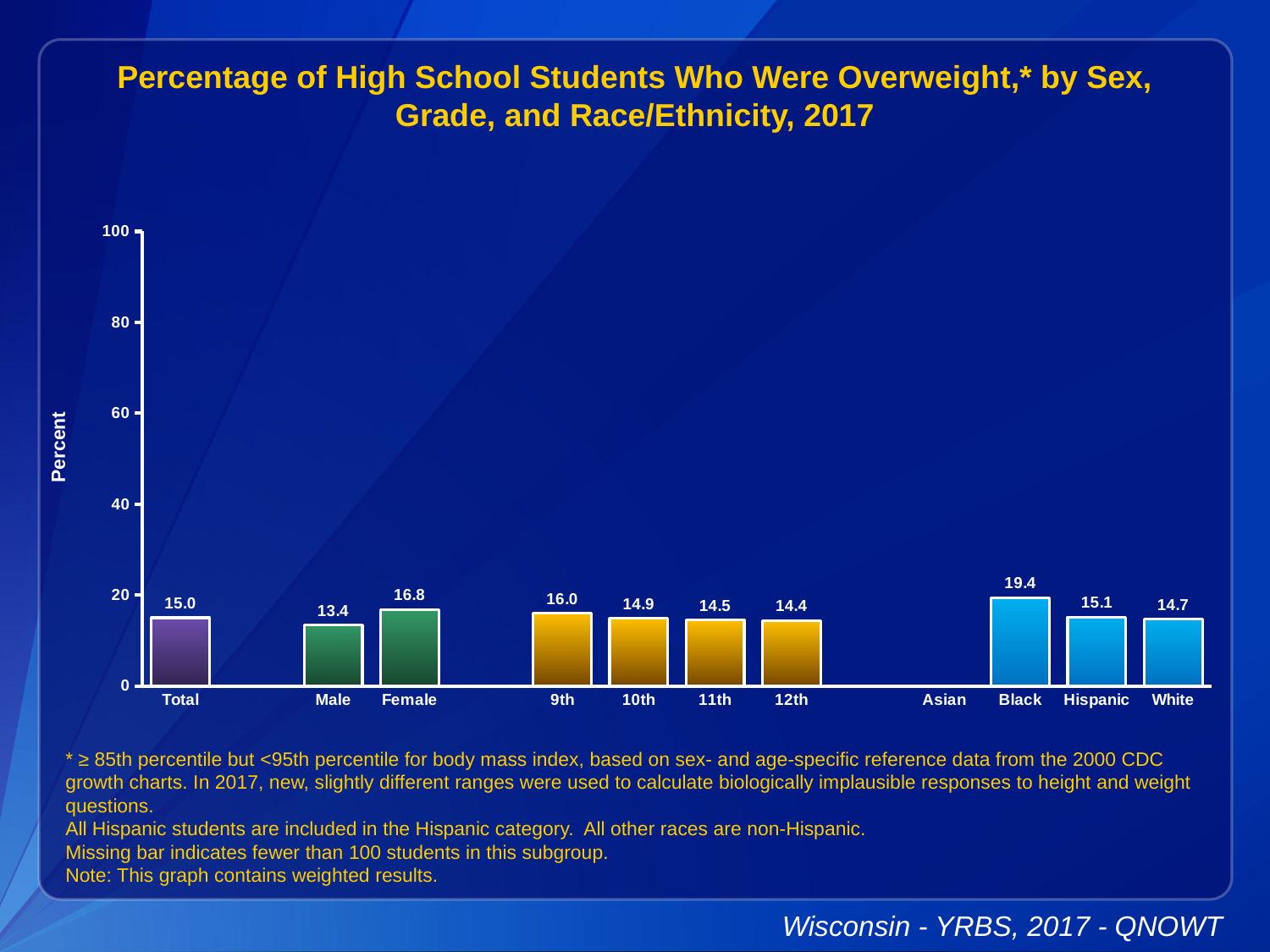
What is the value for Female? 16.8 What is the value for Total? 15.0 What is the value for 12th grade? 14.4 What is the difference between the Female and Male values? 3.4 What is the value for Black students? 19.4 Is the value for Black students greater or less than 20? less What kind of chart is shown? bar chart Which category has the highest value? Black Which category has no bar shown? Asian How many categories have a bar plotted? 11 Which is larger, the value for 9th grade or the value for 10th grade? 9th Which category has the lowest plotted value? Male